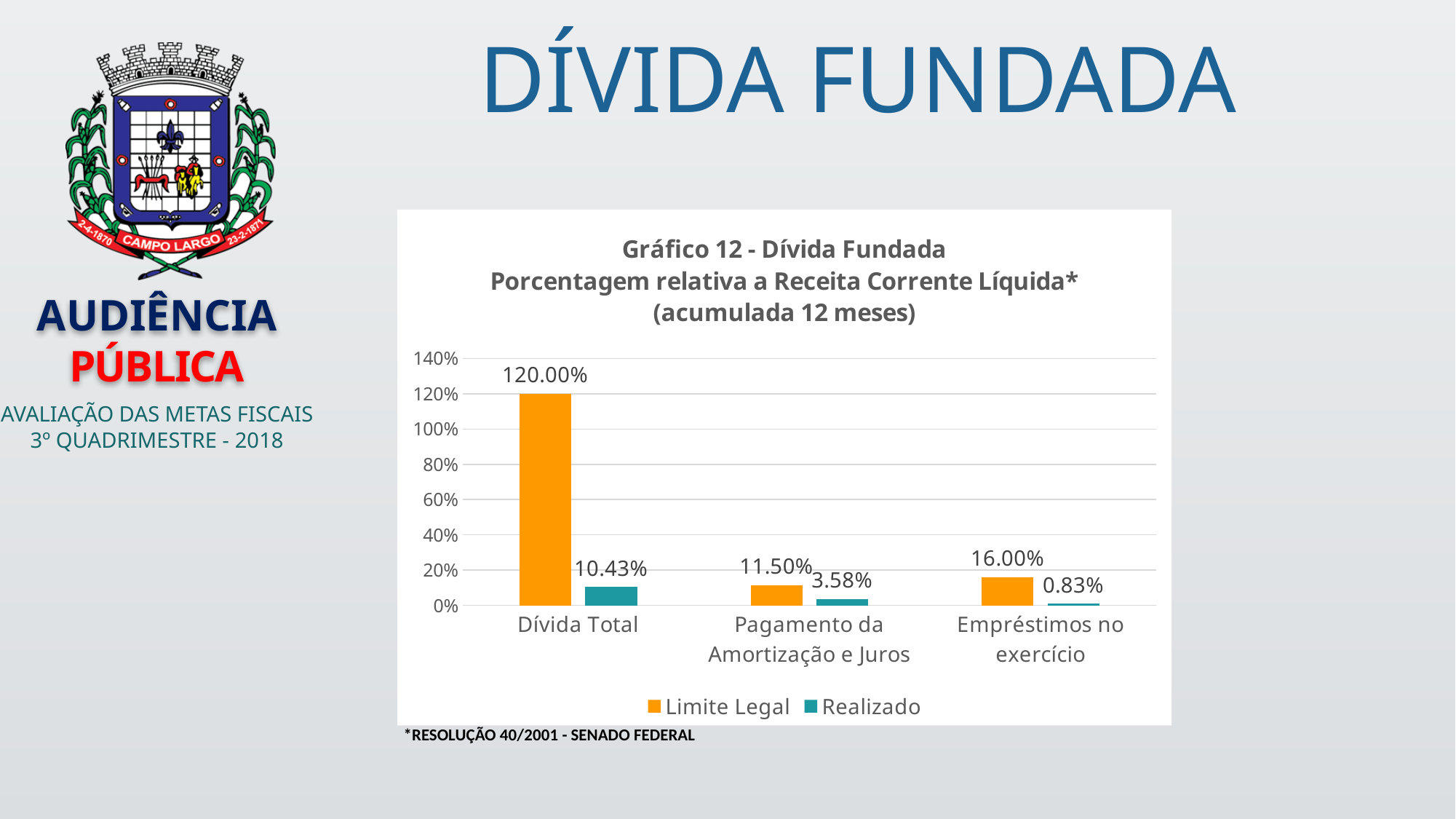
Which category has the highest Limite Legal value? Dívida Total Which category has the lowest Realizado value? Empréstimos no exercício What is the Limite Legal value for Empréstimos no exercício? 16.00% What is the difference between the Limite Legal and Realizado values for Pagamento da Amortização e Juros? 7.92% What is the Realizado value for Dívida Total? 10.43% What is the Realizado value for Pagamento da Amortização e Juros? 3.58% Which is larger: the Limite Legal value for Empréstimos no exercício or the Limite Legal value for Pagamento da Amortização e Juros? Empréstimos no exercício How many categories are shown on the x axis? 3 How many series does the legend list? 2 What is the Realizado value for Empréstimos no exercício? 0.83% What type of chart is shown on the slide? Bar chart What is the Limite Legal value for Dívida Total? 120.00%